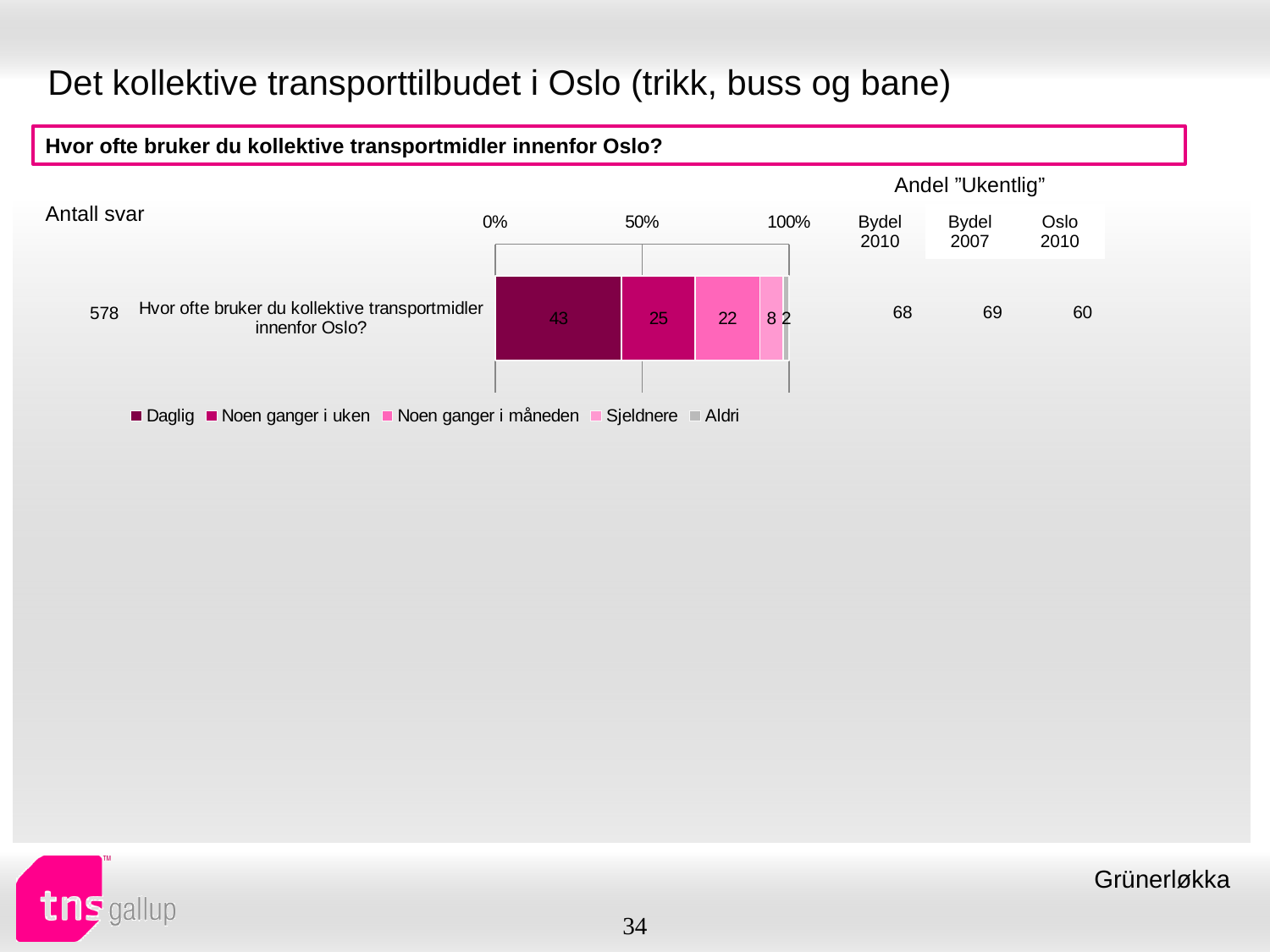
Which series has the smallest segment in the bar? Aldri How many series does the chart legend list? 5 What is the value for "Daglig" in the bar? 43 What is the difference between the "Daglig" and "Noen ganger i uken" values? 18 Which series has the largest segment in the bar? Daglig What kind of chart is shown on the slide? stacked bar chart What is the value for "Aldri" in the bar? 2 Which is larger, the value for "Noen ganger i uken" or the value for "Noen ganger i måneden"? Noen ganger i uken What is the value for "Sjeldnere" in the bar? 8 What is the value for "Noen ganger i uken" in the bar? 25 What is the value for "Noen ganger i måneden" in the bar? 22 What is the total of all segments in the stacked bar? 100